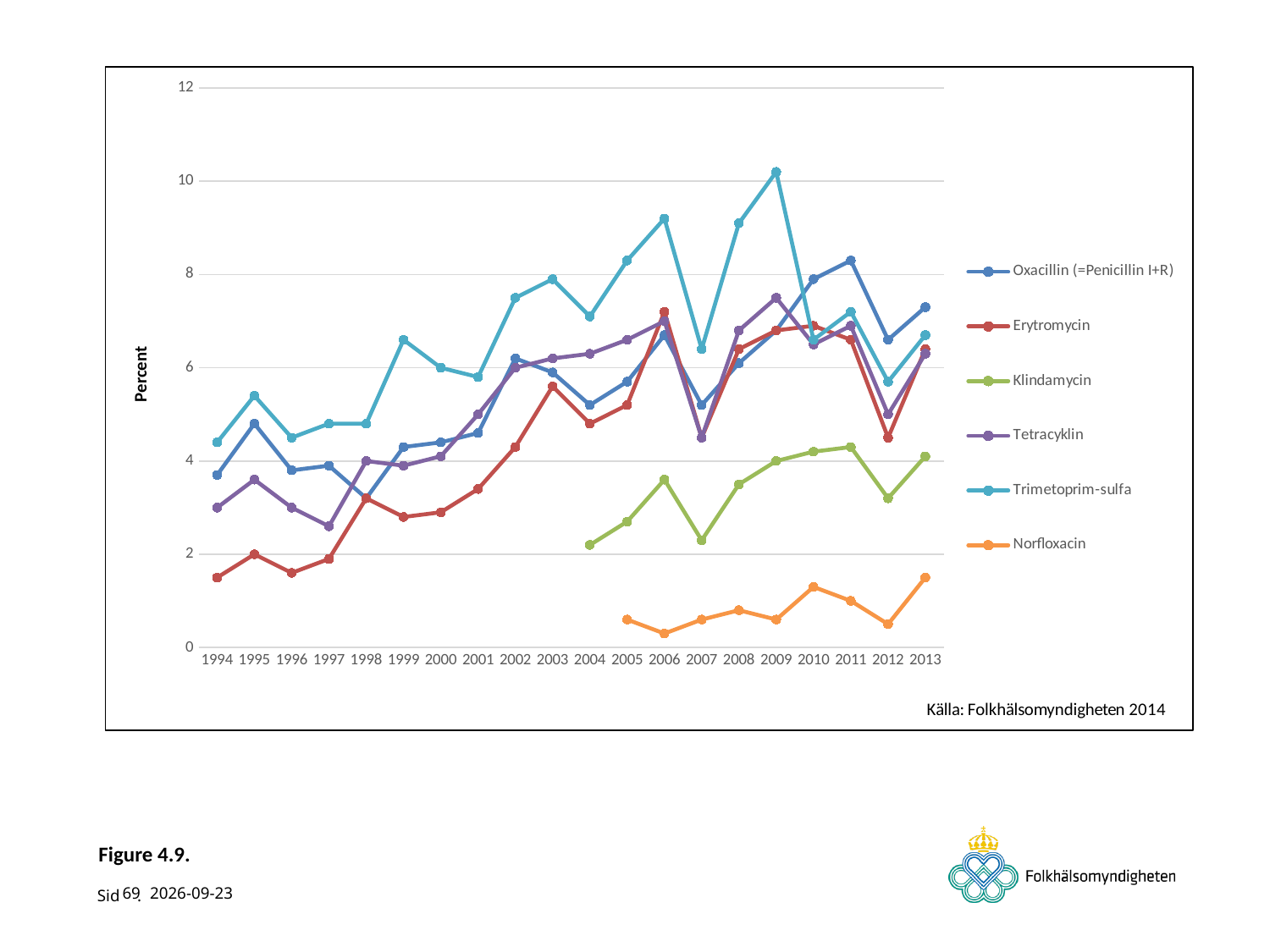
Which series has the highest value in 2009? Trimetoprim-sulfa In 2013, which is larger: Oxacillin (=Penicillin I+R) or Tetracyklin? Oxacillin (=Penicillin I+R) How many years are shown on the x axis? 20 In which year does the Trimetoprim-sulfa line reach its highest point? 2009 Is the value for Trimetoprim-sulfa in 2009 greater or less than 8? greater Does the Klindamycin line rise or fall overall from 2004 to 2013? rise What kind of chart is shown on the slide? line chart How many series does the legend list? 6 Is the value for Norfloxacin in 2013 greater or less than 2? less Is the value for Klindamycin in 2004 greater or less than 4? less Which series has the lowest value in 2013? Norfloxacin What is the label on the y axis? Percent